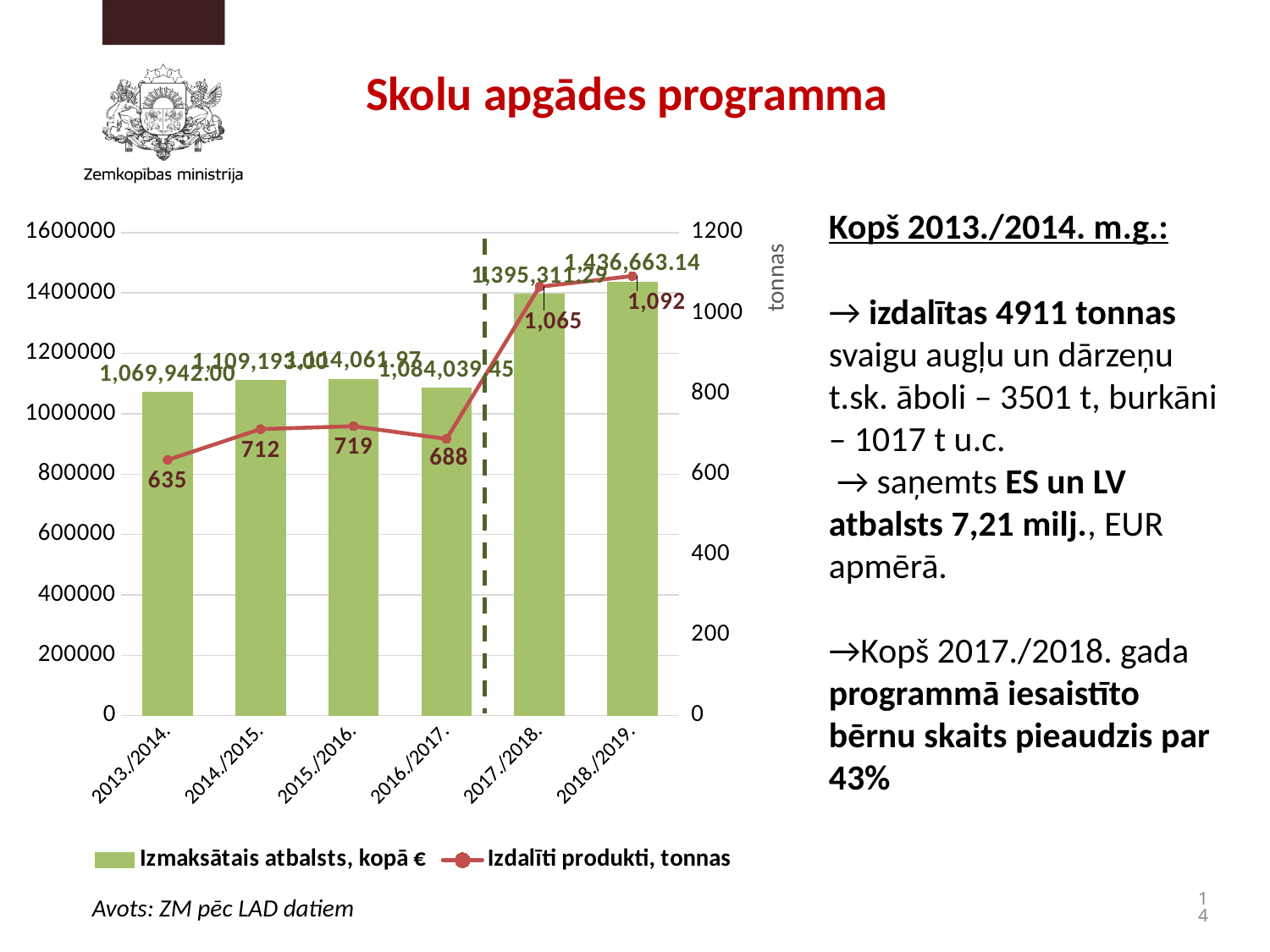
How many school years are shown on the x axis of the chart? 6 How many tonnes of products were distributed (Izdalīti produkti, tonnas) in 2013./2014.? 635 What is the value of Izdalīti produkti, tonnas for 2017./2018.? 1,065 In which school year was the amount of distributed products (tonnas) lowest? 2013./2014. Is the value of Izmaksātais atbalsts, kopā € for 2017./2018. greater or less than 1200000? greater In which school year was the amount of distributed products (tonnas) highest? 2018./2019. How many series does the chart legend list? 2 Which year had more distributed products in tonnes: 2014./2015. or 2016./2017.? 2014./2015. What is the total support paid (Izmaksātais atbalsts, kopā €) for 2018./2019.? 1,436,663.14 What is the label of the right-hand vertical axis of the chart? tonnas What is the value of Izmaksātais atbalsts, kopā € for 2016./2017.? 1,084,039.45 By how many tonnes did distributed products in 2018./2019. exceed those in 2013./2014.? 457